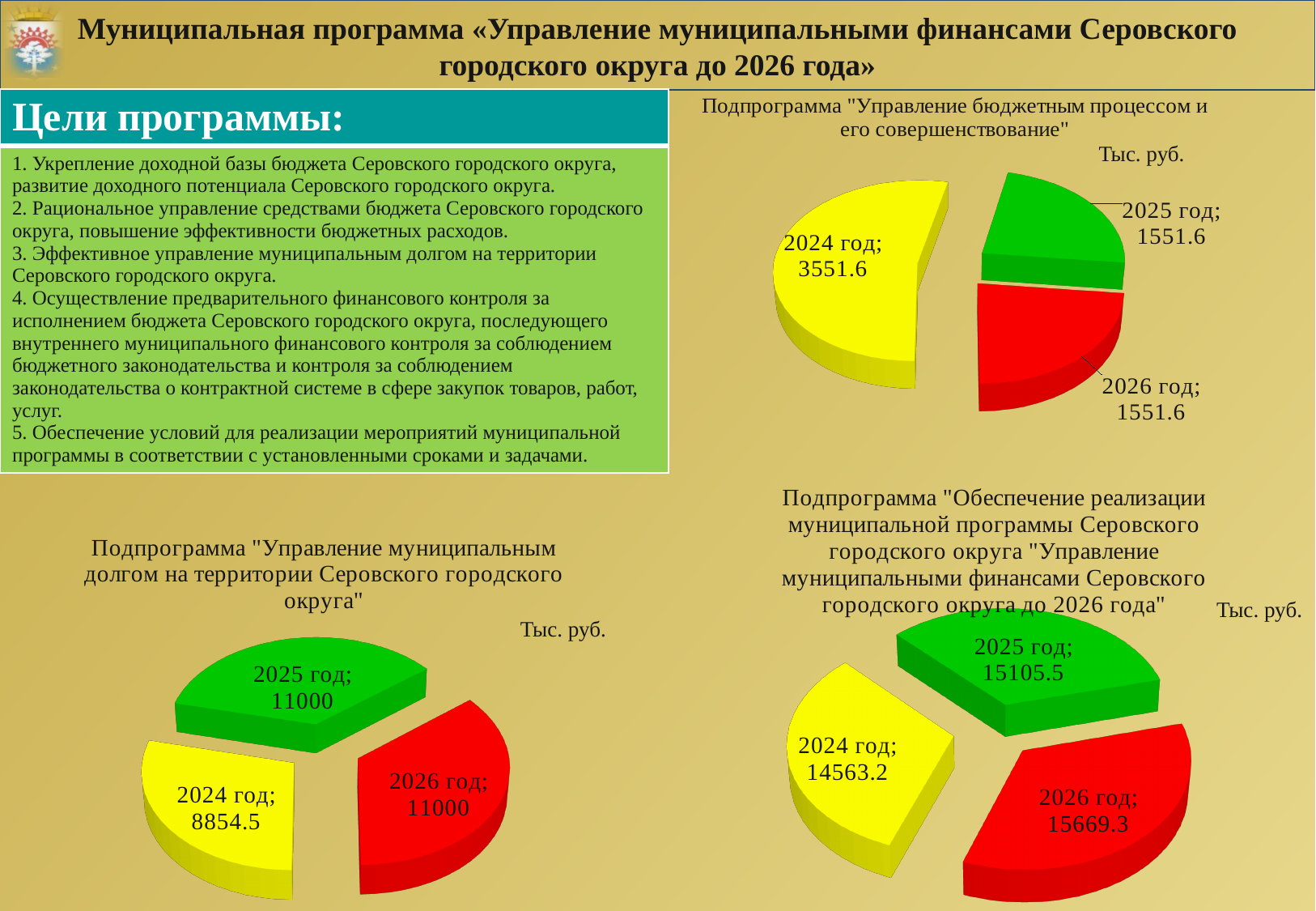
In the bottom-left pie chart ("Управление муниципальным долгом..."), which year has the smallest slice? 2024 год In the bottom-right pie chart ("Обеспечение реализации муниципальной программы..."), what is the value for 2026 год? 15669.3 In the top-right pie chart ("Управление бюджетным процессом и его совершенствование"), what is the value for 2024 год? 3551.6 In the top-right pie chart ("Управление бюджетным процессом и его совершенствование"), what is the difference between the 2024 год and 2025 год values? 2000 In the top-right pie chart ("Управление бюджетным процессом и его совершенствование"), which year has the largest slice? 2024 год In the bottom-right pie chart ("Обеспечение реализации муниципальной программы..."), what is the total of the three slices? 45338.0 In the bottom-left pie chart ("Управление муниципальным долгом..."), what is the value for 2024 год? 8854.5 In the bottom-left pie chart ("Управление муниципальным долгом..."), what is the difference between the 2025 год and 2024 год values? 2145.5 How many slices does the top-right pie chart ("Управление бюджетным процессом и его совершенствование") have? 3 In the bottom-right pie chart ("Обеспечение реализации муниципальной программы..."), which year has the largest value? 2026 год In the bottom-right pie chart ("Обеспечение реализации муниципальной программы..."), which is larger: the value for 2024 год or 2025 год? 2025 год What type of chart is used for the bottom-left chart ("Управление муниципальным долгом...")? Pie chart